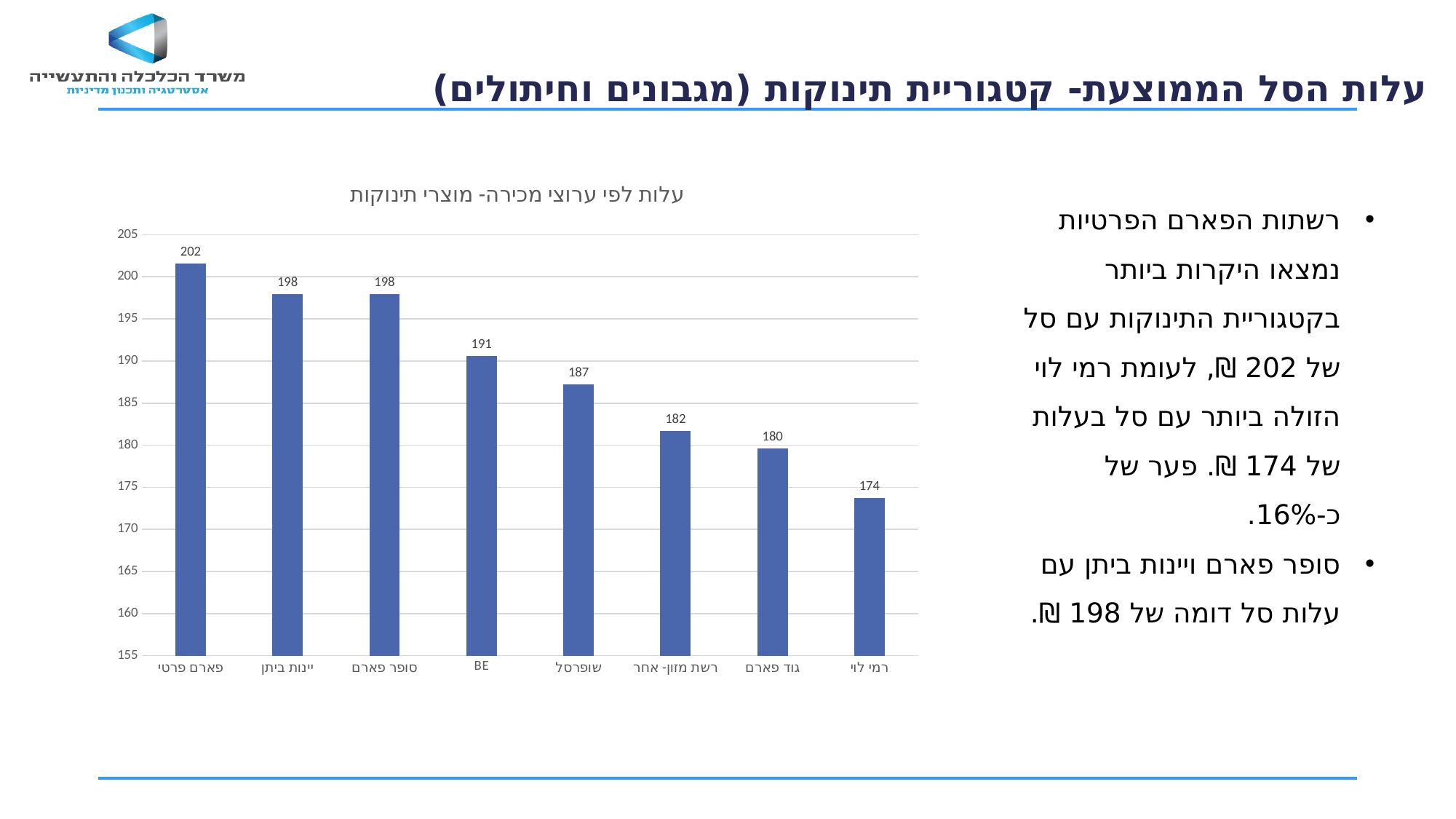
What is the difference between the values for פארם פרטי and רמי לוי? 28 What is the value for רמי לוי? 174 What is the title of the chart? עלות לפי ערוצי מכירה- מוצרי תינוקות How many categories are shown on the x axis? 8 What is the value for שופרסל? 187 Do the values rise or fall from left to right along the x axis? Fall What kind of chart is shown on the slide? Bar chart What is the value for פארם פרטי? 202 Which category has the lowest value? רמי לוי What is the value for BE? 191 Which is larger, the value for גוד פארם or the value for רשת מזון- אחר? רשת מזון- אחר Which category has the highest value? פארם פרטי